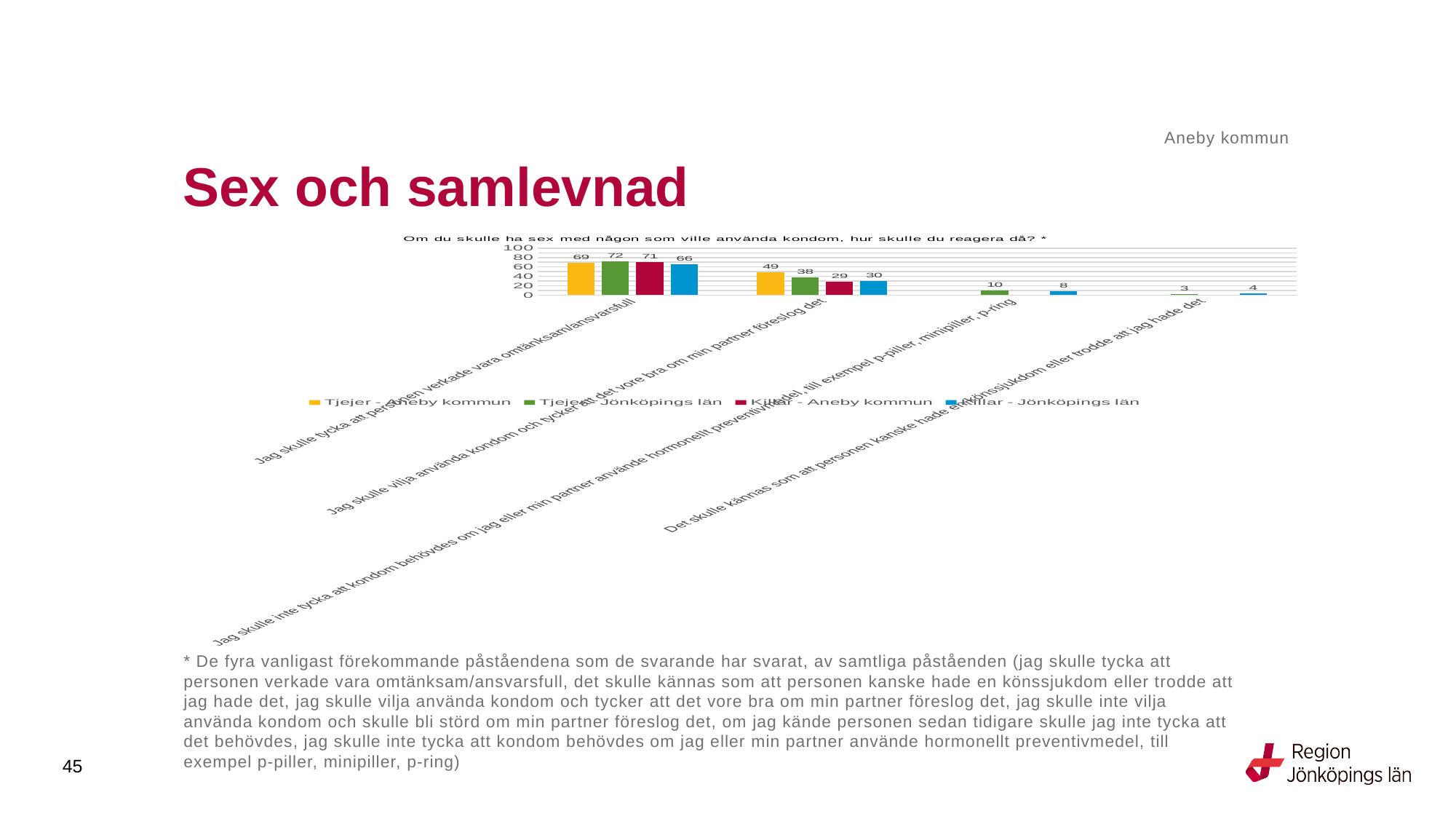
What type of chart is shown on the slide? bar chart How many categories are shown on the x axis of the chart? 4 What is the difference between Tjejer - Aneby kommun and Tjejer - Jönköpings län for 'Jag skulle vilja använda kondom och tycker att det vore bra om min partner föreslog det'? 11 How many series does the legend list? 4 Which is larger for 'Jag skulle inte tycka att kondom behövdes om jag eller min partner använde hormonellt preventivmedel': Tjejer - Jönköpings län or Killar - Jönköpings län? Tjejer - Jönköpings län Which series has the lowest value for 'Jag skulle vilja använda kondom och tycker att det vore bra om min partner föreslog det'? Killar - Aneby kommun Which series has the highest value for 'Jag skulle tycka att personen verkade vara omtänksam/ansvarsfull'? Tjejer - Jönköpings län What is the value for Tjejer - Jönköpings län for 'Jag skulle vilja använda kondom och tycker att det vore bra om min partner föreslog det'? 38 What colour represents Killar - Aneby kommun in the chart? red What is the value for Tjejer - Aneby kommun for 'Jag skulle tycka att personen verkade vara omtänksam/ansvarsfull'? 69 What is the value for Killar - Aneby kommun for 'Jag skulle tycka att personen verkade vara omtänksam/ansvarsfull'? 71 What is the value for Killar - Jönköpings län for 'Det skulle kännas som att personen kanske hade en könssjukdom eller trodde att jag hade det'? 4